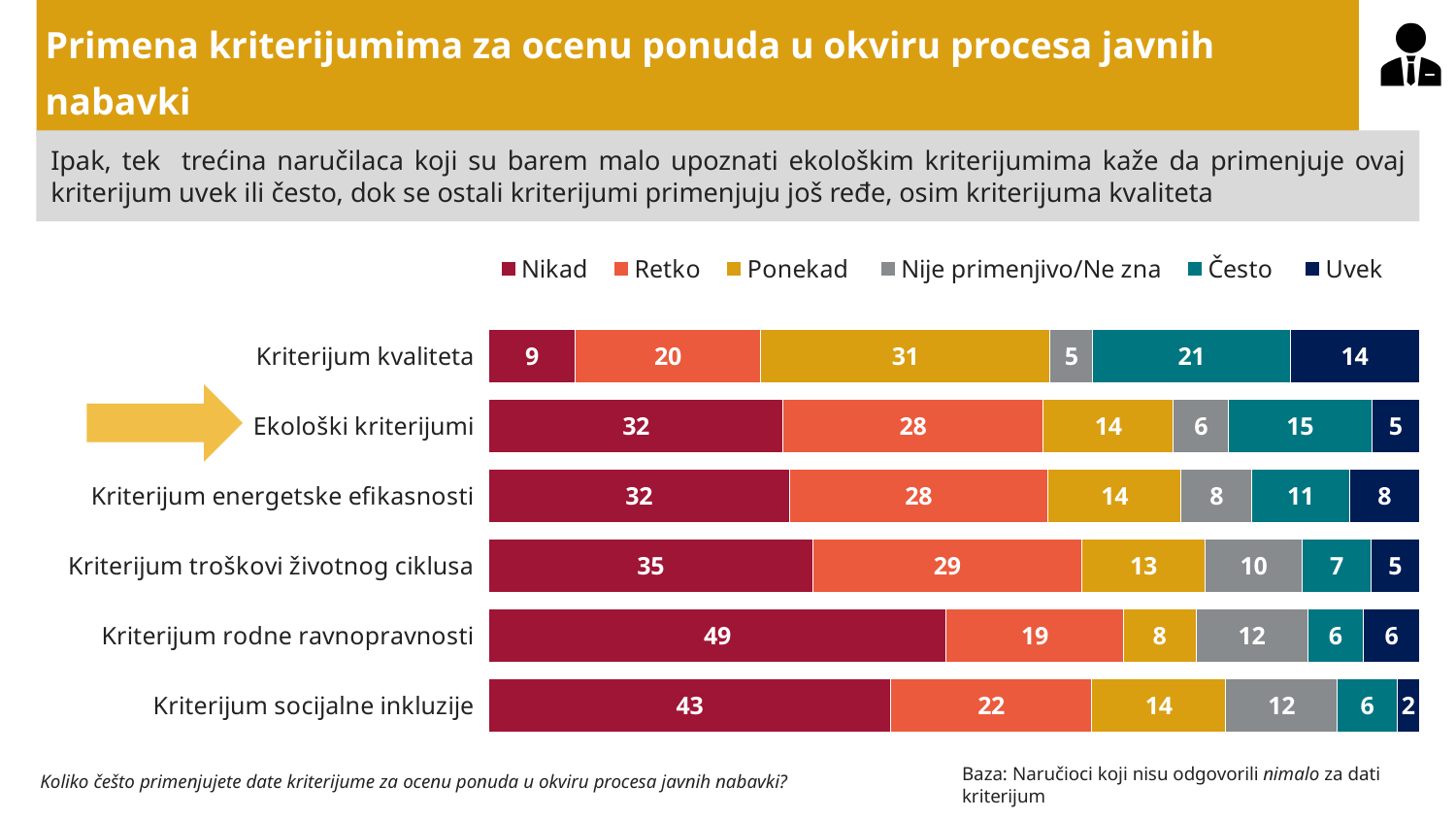
How many categories (criteria) are plotted on the chart? 6 What is the value of "Ponekad" for Kriterijum kvaliteta? 31 What is the value of "Uvek" for Kriterijum socijalne inkluzije? 2 Which category has the lowest "Nikad" value? Kriterijum kvaliteta What is the value of "Često" for Ekološki kriterijumi? 15 What kind of chart is shown on the slide? Stacked bar chart Which category has the highest "Nikad" value? Kriterijum rodne ravnopravnosti Which is larger: the "Retko" value for Kriterijum troškovi životnog ciklusa or for Kriterijum socijalne inkluzije? Kriterijum troškovi životnog ciklusa What is the difference between the "Uvek" values for Kriterijum kvaliteta and Ekološki kriterijumi? 9 How many series does the legend list? 6 What is the total of the stacked bar for Kriterijum kvaliteta? 100 What is the value of "Nikad" for Kriterijum rodne ravnopravnosti? 49